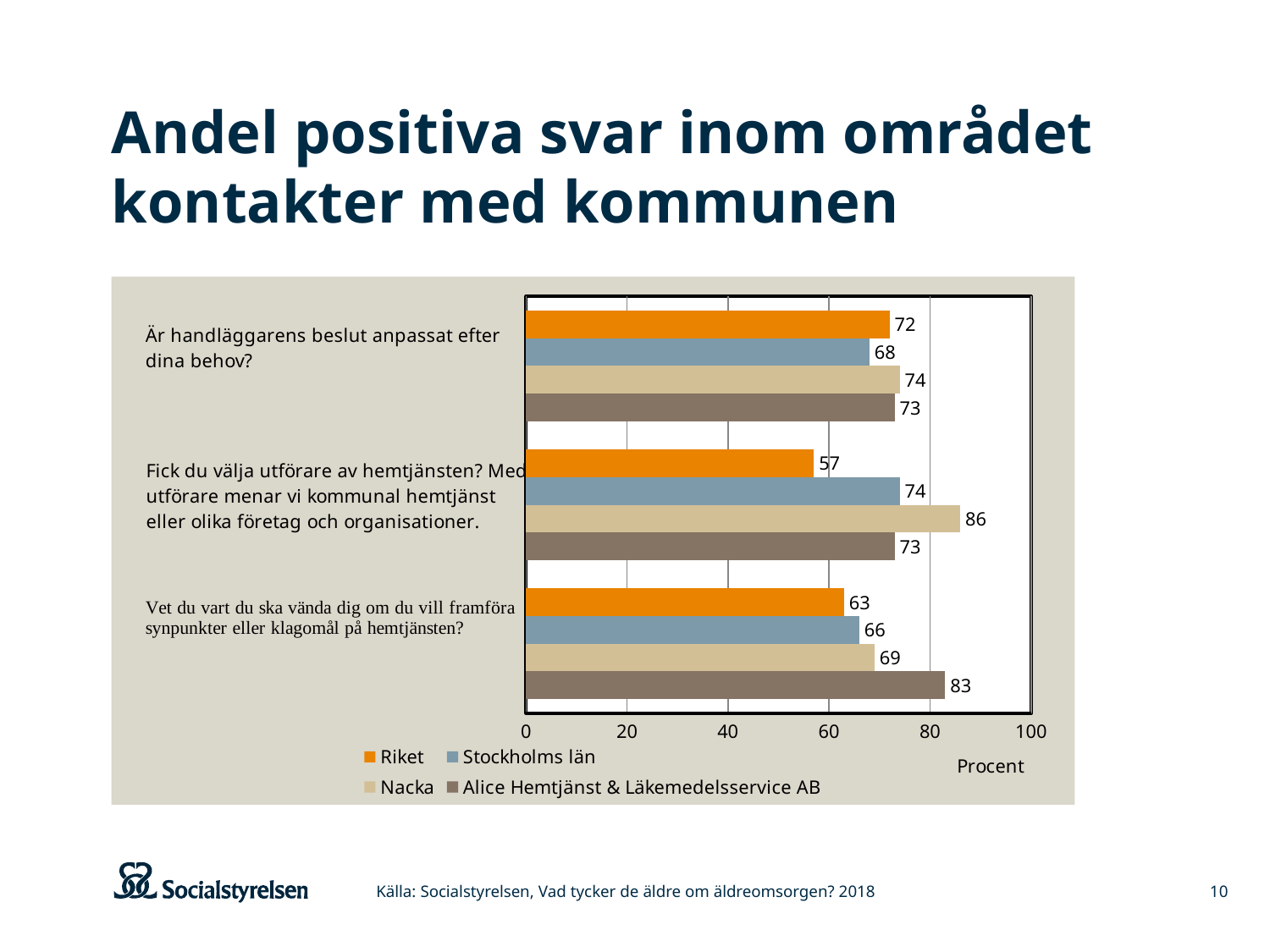
Which series has the highest value on the question "Fick du välja utförare av hemtjänsten?"? Nacka What is the value for Nacka on the question "Fick du välja utförare av hemtjänsten?"? 86 What is the difference between Alice Hemtjänst & Läkemedelsservice AB and Nacka on the question "Vet du vart du ska vända dig om du vill framföra synpunkter eller klagomål på hemtjänsten?"? 14 What is the value for Alice Hemtjänst & Läkemedelsservice AB on the question "Vet du vart du ska vända dig om du vill framföra synpunkter eller klagomål på hemtjänsten?"? 83 What is the difference between Nacka and Riket on the question "Fick du välja utförare av hemtjänsten?"? 29 Which is larger on the question "Är handläggarens beslut anpassat efter dina behov?": Riket or Stockholms län? Riket What is the value for Stockholms län on the question "Vet du vart du ska vända dig om du vill framföra synpunkter eller klagomål på hemtjänsten?"? 66 Which series has the lowest value on the question "Fick du välja utförare av hemtjänsten?"? Riket What kind of chart is shown on the slide? Bar chart How many question categories are shown on the chart? 3 How many series does the legend list? 4 What is the value for Riket on the question "Är handläggarens beslut anpassat efter dina behov?"? 72